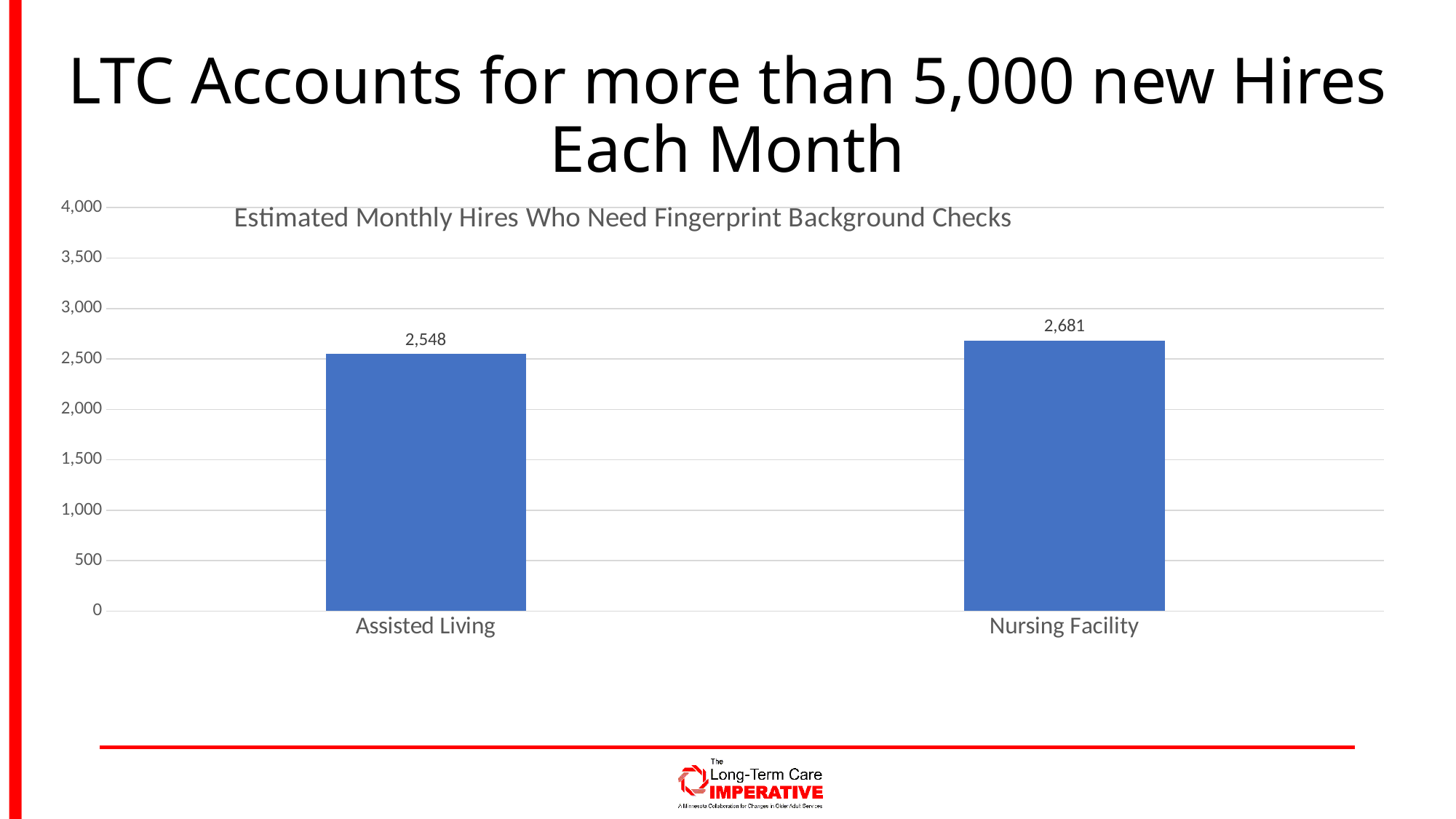
What is the highest value shown on the vertical axis? 4,000 What is the total of the two values shown on the chart? 5,229 What is the difference between the Nursing Facility and Assisted Living values? 133 What is the estimated monthly hires value for Nursing Facility? 2,681 How many categories are shown on the chart? 2 What is the estimated monthly hires value for Assisted Living? 2,548 Is the value for Assisted Living greater or less than 3,000? less What kind of chart is shown on the slide? Bar chart Which category has the higher value, Assisted Living or Nursing Facility? Nursing Facility Is the value for Nursing Facility greater or less than 2,500? greater What is the title of the chart? Estimated Monthly Hires Who Need Fingerprint Background Checks Which category has the lowest value? Assisted Living